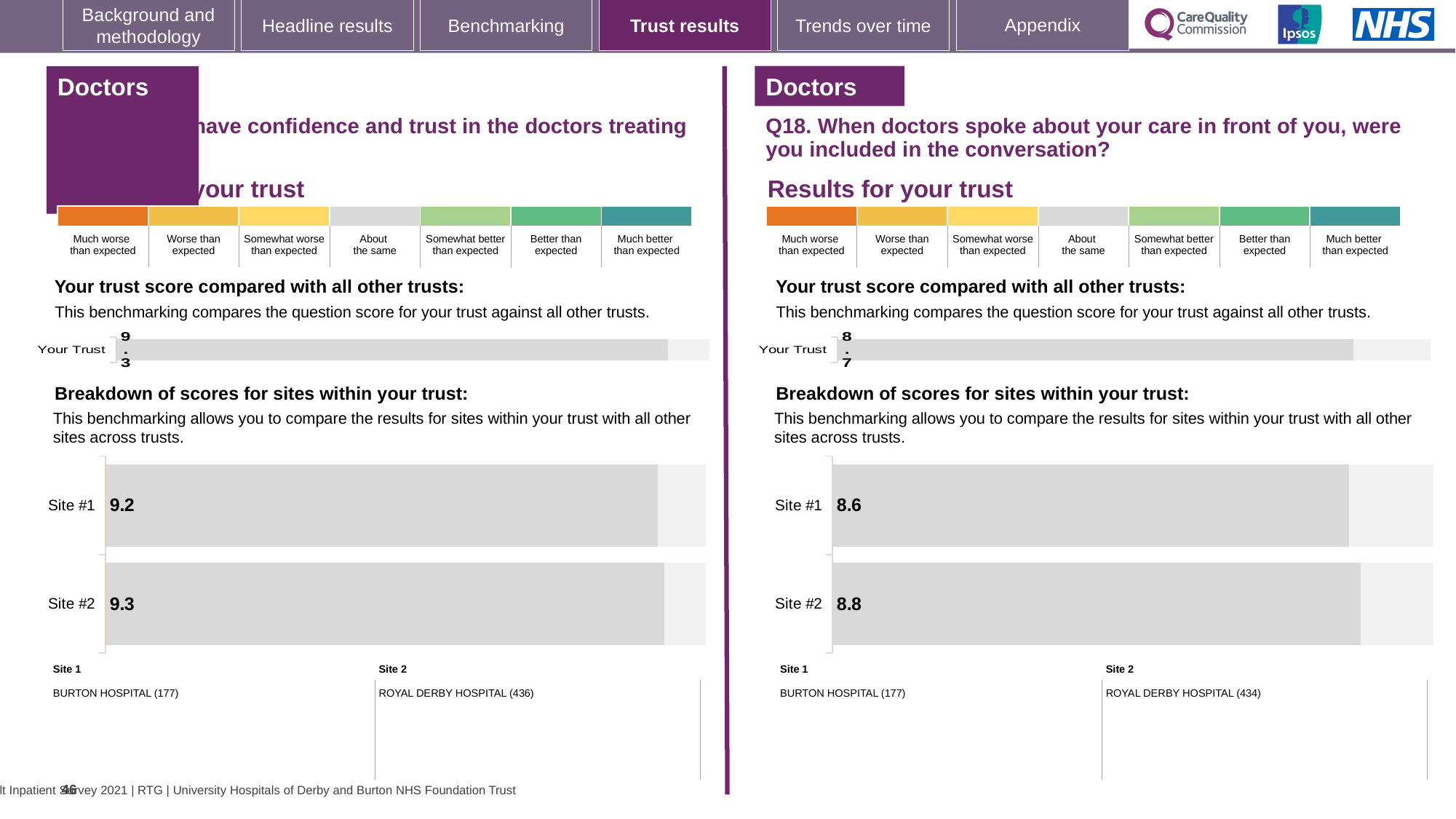
On the left-hand site breakdown chart, what is the score for Site #2? 9.3 On the left-hand 'Your trust score compared with all other trusts' chart, what is the value shown for Your Trust? 9.3 On the left-hand site breakdown chart, which site has the lower score? Site #1 How many sites are shown on the right-hand (Q18) site breakdown chart? 2 What type of chart is used for the site breakdown on the right-hand (Q18) side of the slide? Bar chart On the left-hand site breakdown chart, what is the score for Site #1? 9.2 On the right-hand (Q18) 'Your trust score compared with all other trusts' chart, what is the value shown for Your Trust? 8.7 On the left-hand site breakdown chart, what is the difference between the Site #2 and Site #1 scores? 0.1 On the right-hand (Q18) site breakdown chart, what is the score for Site #2? 8.8 On the right-hand (Q18) site breakdown chart, what is the score for Site #1? 8.6 On the right-hand (Q18) site breakdown chart, what is the difference between the Site #2 and Site #1 scores? 0.2 On the right-hand (Q18) site breakdown chart, which site has the higher score? Site #2